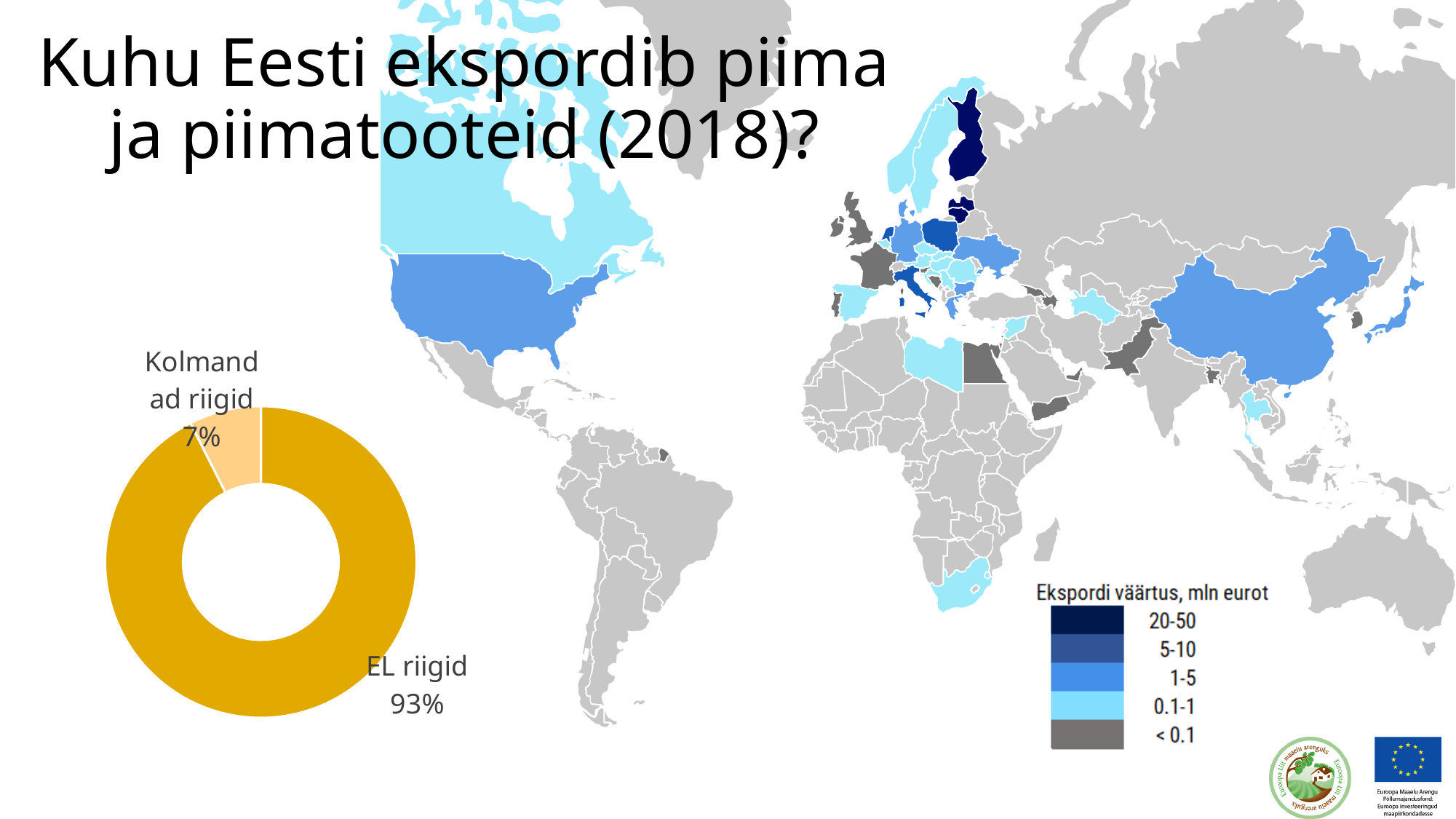
How many value ranges does the map legend list? 5 What is the total of the two slices in the donut chart? 100% How many slices does the donut chart have? 2 What is the difference in percentage points between the EL riigid slice and the Kolmandad riigid slice? 86 percentage points In the donut chart, what share of exports goes to EL riigid? 93% What kind of chart is shown on the left of the slide? Donut (pie) chart Which slice of the donut chart is the smallest? Kolmandad riigid Which slice of the donut chart is the largest? EL riigid Which is larger in the donut chart, EL riigid or Kolmandad riigid? EL riigid On the map, what is the title of the legend? Ekspordi väärtus, mln eurot In the donut chart, what share of exports goes to Kolmandad riigid? 7% What colour is the EL riigid slice in the donut chart? Gold/yellow